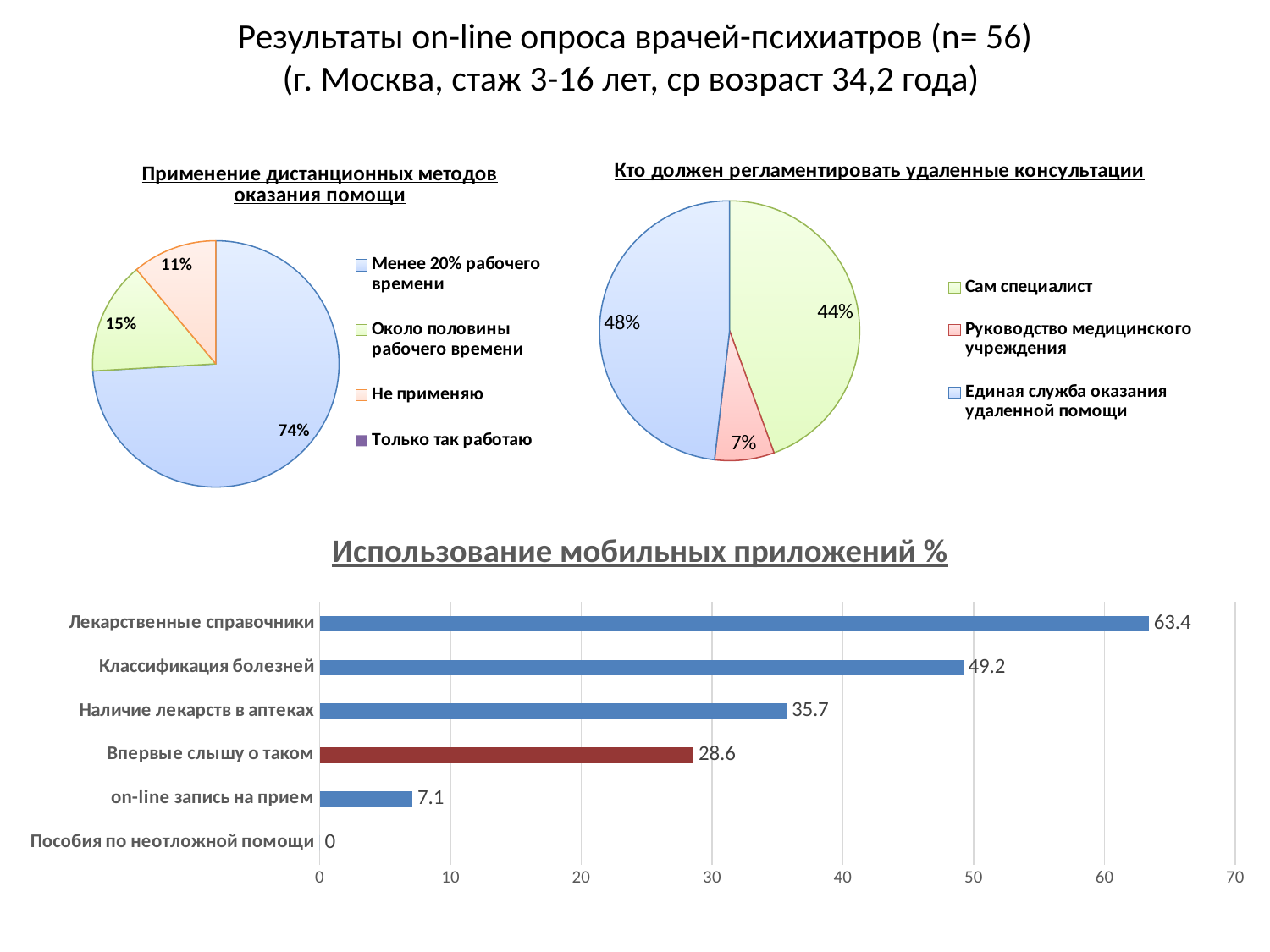
In the pie chart 'Кто должен регламентировать удаленные консультации', what share is shown for 'Сам специалист'? 44% In the chart 'Использование мобильных приложений %', what is the value for 'Классификация болезней'? 49.2 In the chart 'Использование мобильных приложений %', how many categories are shown? 6 In the pie chart 'Кто должен регламентировать удаленные консультации', which category has the smallest share? Руководство медицинского учреждения What kind of chart is 'Использование мобильных приложений %'? bar chart In the pie chart 'Применение дистанционных методов оказания помощи', what share is shown for 'Менее 20% рабочего времени'? 74% In the chart 'Использование мобильных приложений %', what is the difference between 'Лекарственные справочники' and 'Наличие лекарств в аптеках'? 27.7 In the chart 'Использование мобильных приложений %', which category has the highest value? Лекарственные справочники In the pie chart 'Применение дистанционных методов оказания помощи', how many entries does the legend list? 4 In the pie chart 'Применение дистанционных методов оказания помощи', what share is shown for 'Не применяю'? 11% In the chart 'Использование мобильных приложений %', which bar is coloured differently (red) from the others? Впервые слышу о таком In the pie chart 'Кто должен регламентировать удаленные консультации', what is the difference between the shares for 'Единая служба оказания удаленной помощи' and 'Сам специалист'? 4%